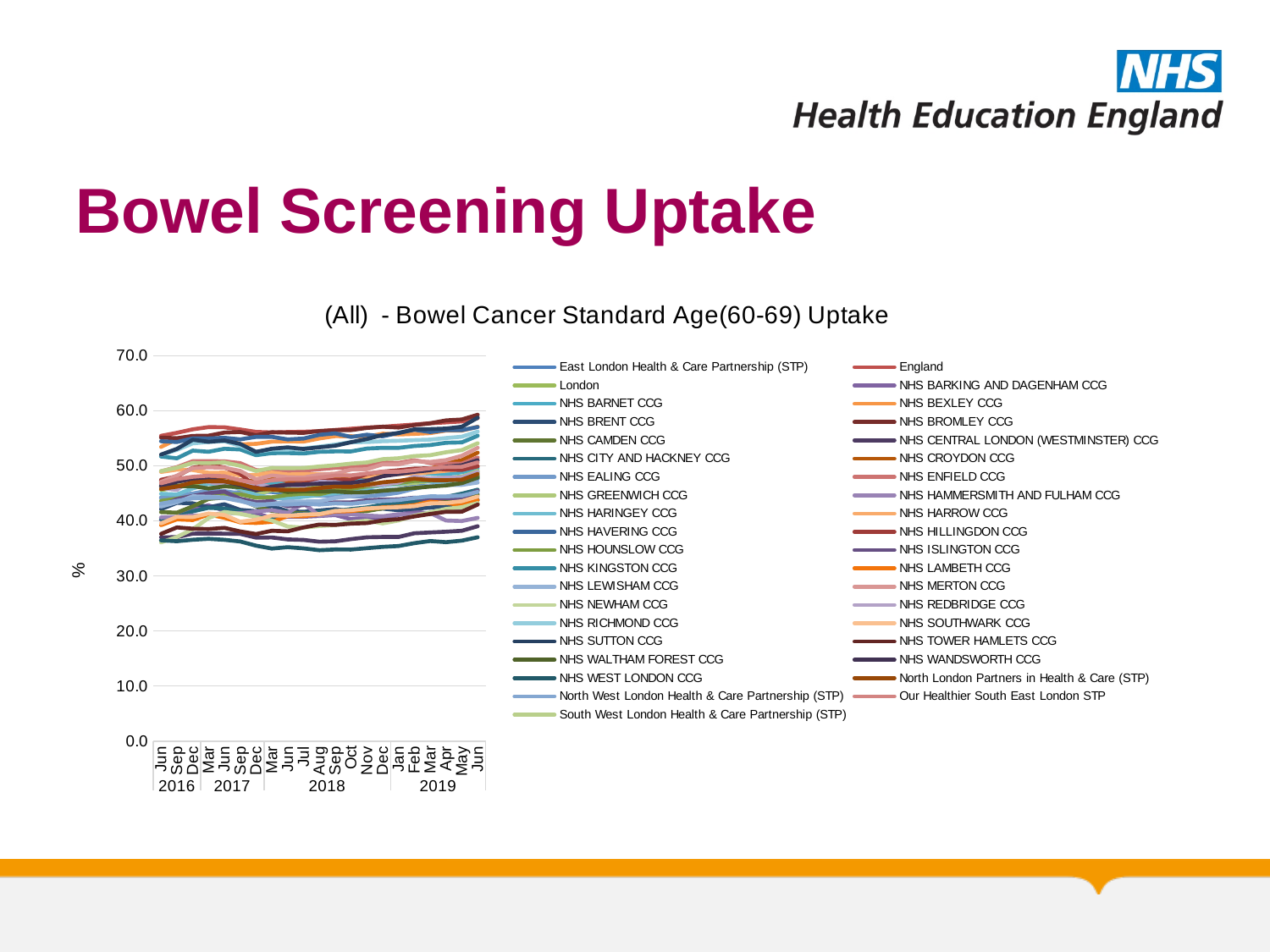
What is the title of the chart? (All) - Bowel Cancer Standard Age(60-69) Uptake What is the lowest value shown on the y axis of the chart? 0.0 What is the label on the y axis of the chart? % What is the highest value shown on the y axis of the chart? 70.0 What kind of chart is shown on the slide? line chart Are the plotted values for all series greater or less than 30? greater Are the plotted values for all series greater or less than 20? greater How many years are labelled along the x axis of the chart? 4 What is the first month labelled on the x axis of the chart? Jun Are the plotted values for all series greater or less than 70? less Which years are labelled along the x axis of the chart? 2016, 2017, 2018, 2019 How many series does the chart's legend list? 39